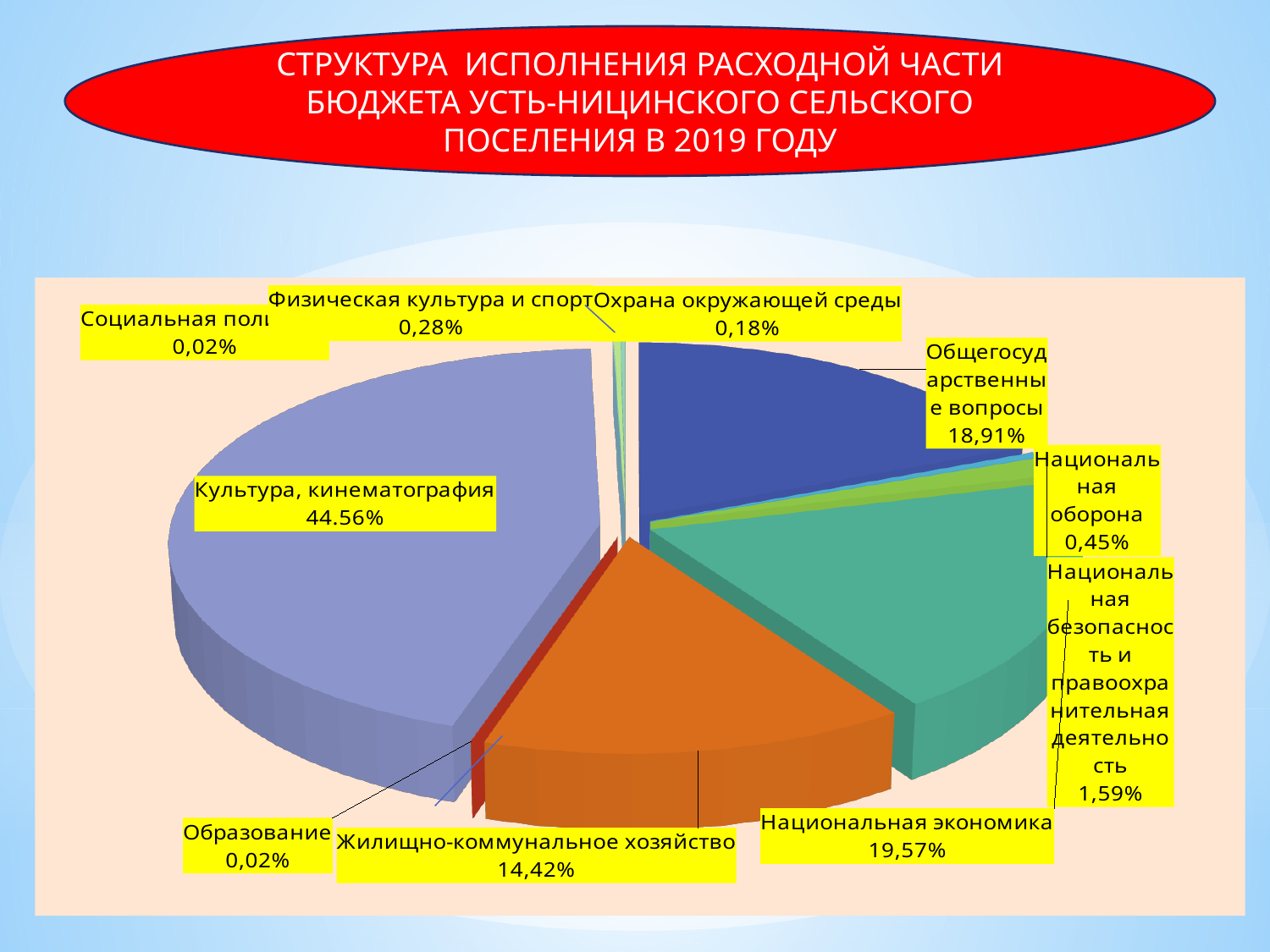
Which year does the budget expenditure structure in the slide title refer to? 2019 What is the value shown for Жилищно-коммунальное хозяйство? 14,42% What is the difference between the shares of Национальная экономика and Общегосударственные вопросы? 0,66% What is the value shown for Охрана окружающей среды? 0,18% What kind of chart is shown on the slide? pie chart What share of the budget expenditure goes to Культура, кинематография? 44.56% What is the value shown for Национальная безопасность и правоохранительная деятельность? 1,59% What is the value shown for Национальная экономика? 19,57% Which is larger: Национальная экономика or Общегосударственные вопросы? Национальная экономика Which category has the largest share of the pie? Культура, кинематография How many categories are labelled on the pie chart? 10 What is the value shown for Общегосударственные вопросы? 18,91%